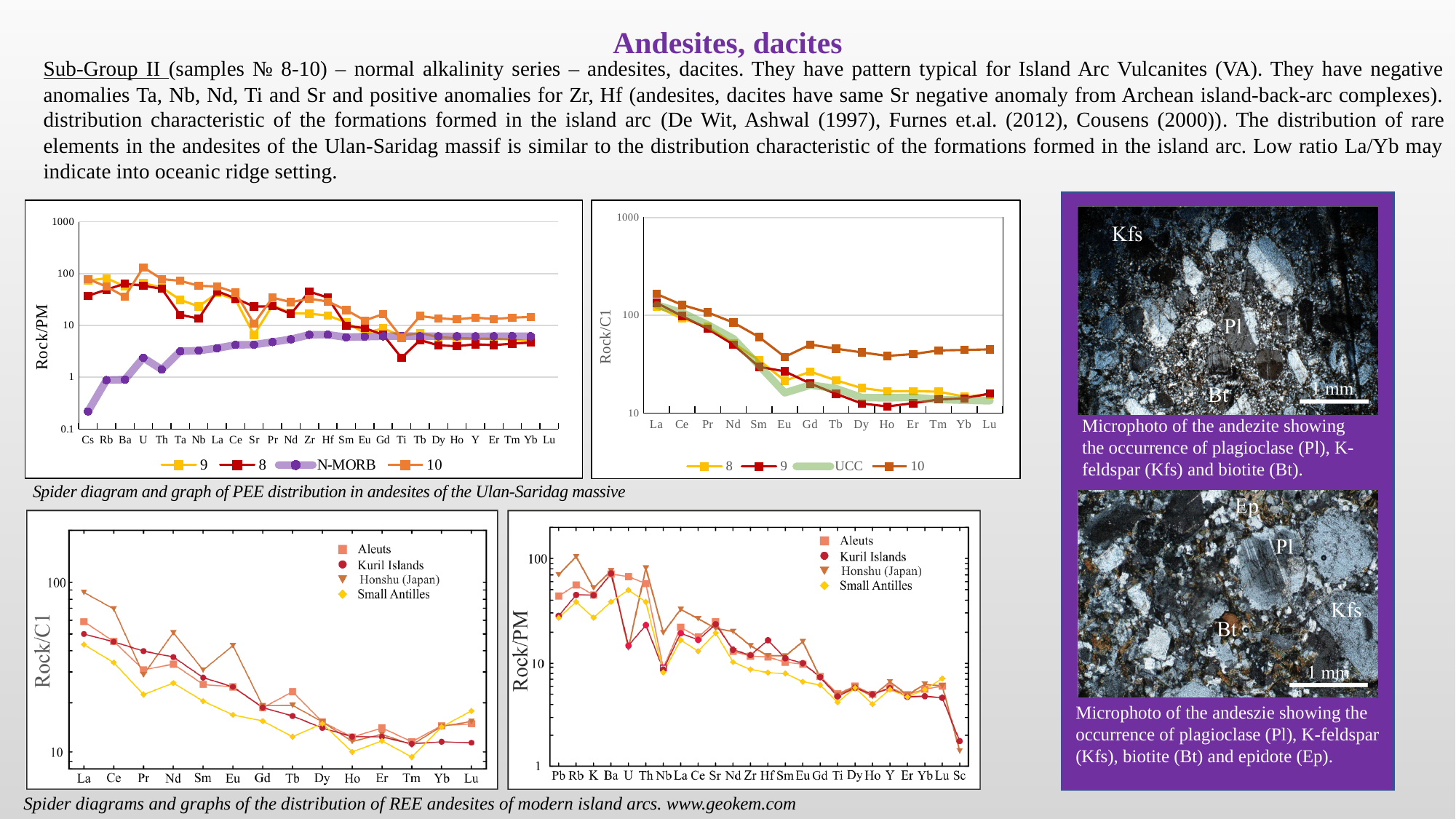
In the bottom-right chart (Rock/PM), how many elements are shown along the x axis? 24 In the top-right chart (Rock/C1), is the value of series 10 at La greater or less than 100? greater What kind of chart is the bottom-left chart (Rock/C1, Aleuts, Kuril Islands, Honshu, Small Antilles)? line chart In the top-right chart (Rock/C1), which is larger at Ho: series 10 or series 9? 10 In the top-left chart (Rock/PM), is the value of N-MORB at Cs greater or less than 1? less In the top-left chart (Rock/PM spider diagram), how many series does the legend list? 4 In the bottom-right chart (Rock/PM), is the value of Kuril Islands at Sc greater or less than 10? less In the top-right chart (Rock/C1), what are the legend entries? 8, 9, UCC, 10 In the top-right chart (Rock/C1), how many elements are shown along the x axis? 14 In the bottom-left chart (Rock/C1), how many series does the legend list? 4 In the top-right chart (Rock/C1), does series 10 generally rise or fall from La to Lu? fall